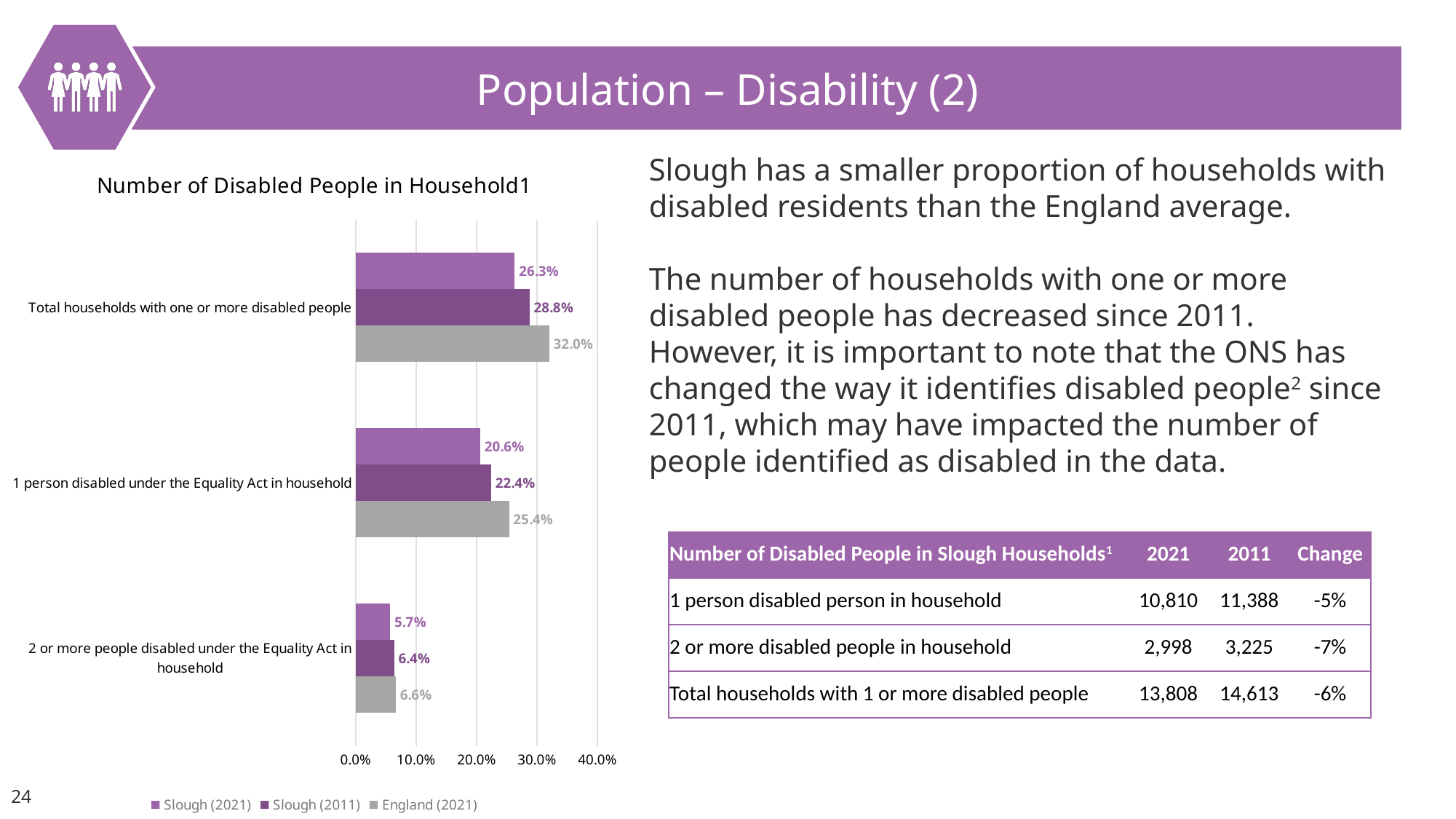
What is the difference between the England (2021) and Slough (2021) values for Total households with one or more disabled people? 5.7% Is the Slough (2011) value for Total households with one or more disabled people greater or less than 30.0%? less What is the title of the chart? Number of Disabled People in Household1 What is the Slough (2021) value for Total households with one or more disabled people? 26.3% What is the England (2021) value for 1 person disabled under the Equality Act in household? 25.4% What is the Slough (2011) value for 2 or more people disabled under the Equality Act in household? 6.4% How many series does the legend list? 3 What kind of chart is shown on the slide? Bar chart Which is larger for 1 person disabled under the Equality Act in household: Slough (2021) or Slough (2011)? Slough (2011) Which category has the lowest Slough (2021) value? 2 or more people disabled under the Equality Act in household How many categories are shown on the chart? 3 Which series has the highest value for Total households with one or more disabled people? England (2021)